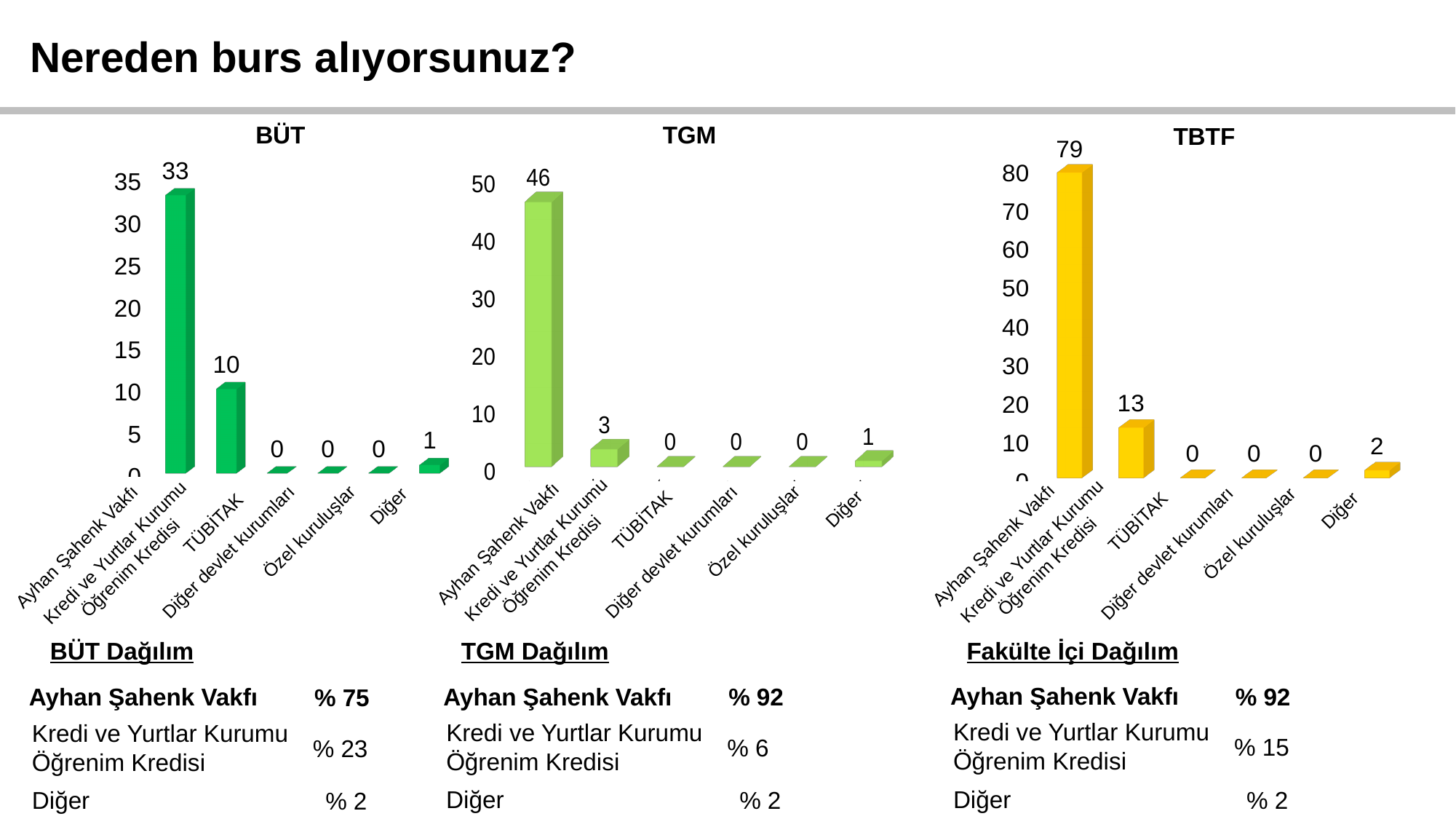
In the TGM chart, what is the value for Kredi ve Yurtlar Kurumu Öğrenim Kredisi? 3 In the TBTF chart, what is the value for Diğer? 2 In the BÜT chart, what is the difference between Ayhan Şahenk Vakfı and Kredi ve Yurtlar Kurumu Öğrenim Kredisi? 23 In the TBTF chart, what is the value for TÜBİTAK? 0 In the TGM chart, what is the difference between Ayhan Şahenk Vakfı and Diğer? 45 In the TBTF chart, which category has the highest value? Ayhan Şahenk Vakfı What colour are the bars in the TBTF chart? yellow In the BÜT chart, what is the value for Ayhan Şahenk Vakfı? 33 What kind of chart is the BÜT chart? bar chart In the TBTF chart, is the value for Ayhan Şahenk Vakfı greater or less than 70? greater In the TGM chart, which is larger: Ayhan Şahenk Vakfı or Kredi ve Yurtlar Kurumu Öğrenim Kredisi? Ayhan Şahenk Vakfı How many categories are shown on the x axis of the TGM chart? 6